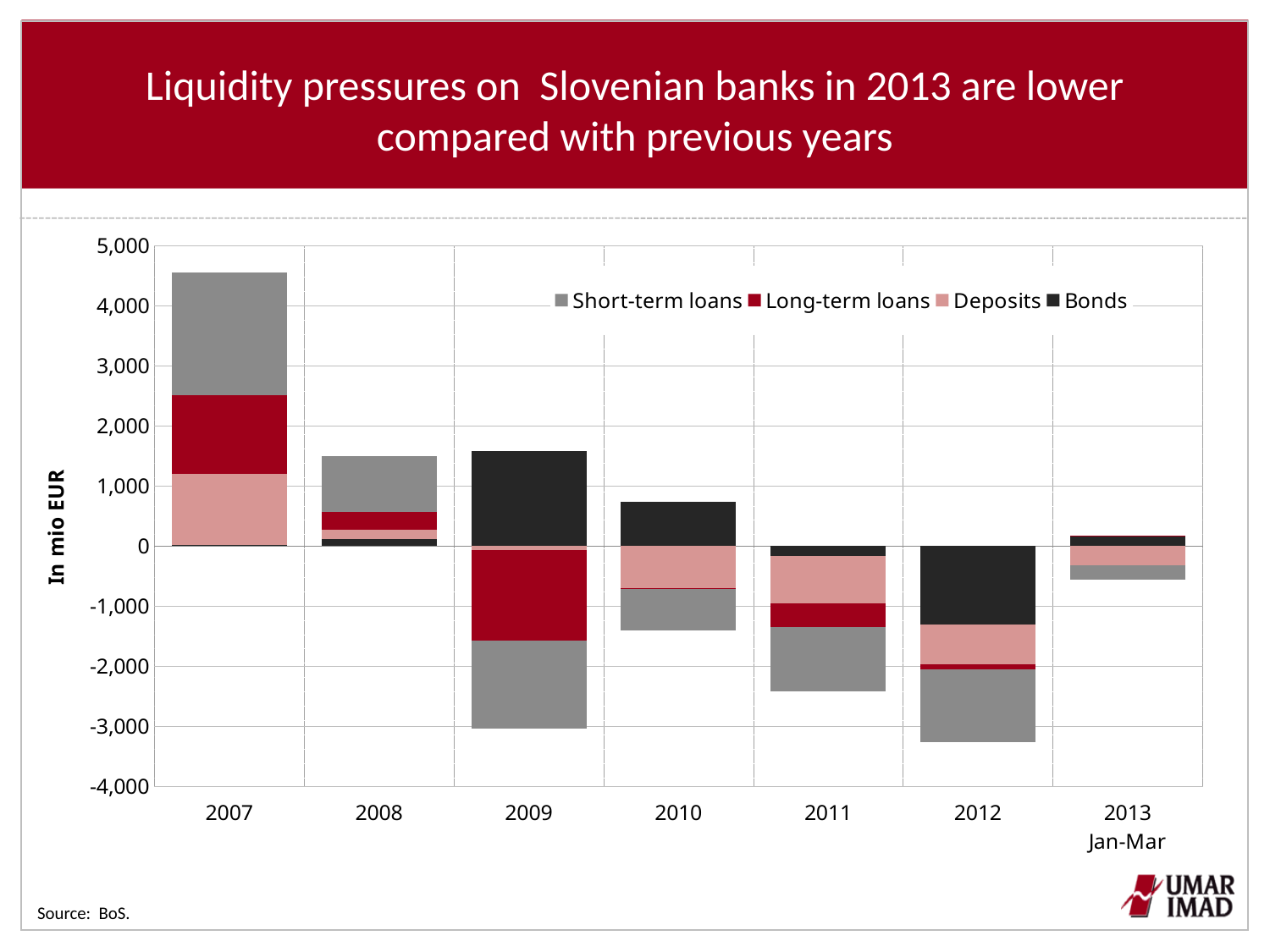
How many years (categories) are shown along the x axis? 7 How many series does the legend list? 4 Which is larger, the Bonds value for 2009 or the Bonds value for 2010? 2009 Which is larger, the Short-term loans value for 2007 or for 2008? 2007 Which series is shown in black in the legend? Bonds Which year has the tallest positive stacked bar? 2007 Is the top of the positive stacked bar for 2007 greater or less than 4,000? greater Is the Bonds value for 2009 greater or less than 1,000? greater What kind of chart is shown on the slide? Stacked bar chart What is the label on the vertical axis? In mio EUR Is the top of the positive stacked bar for 2008 greater or less than 2,000? less